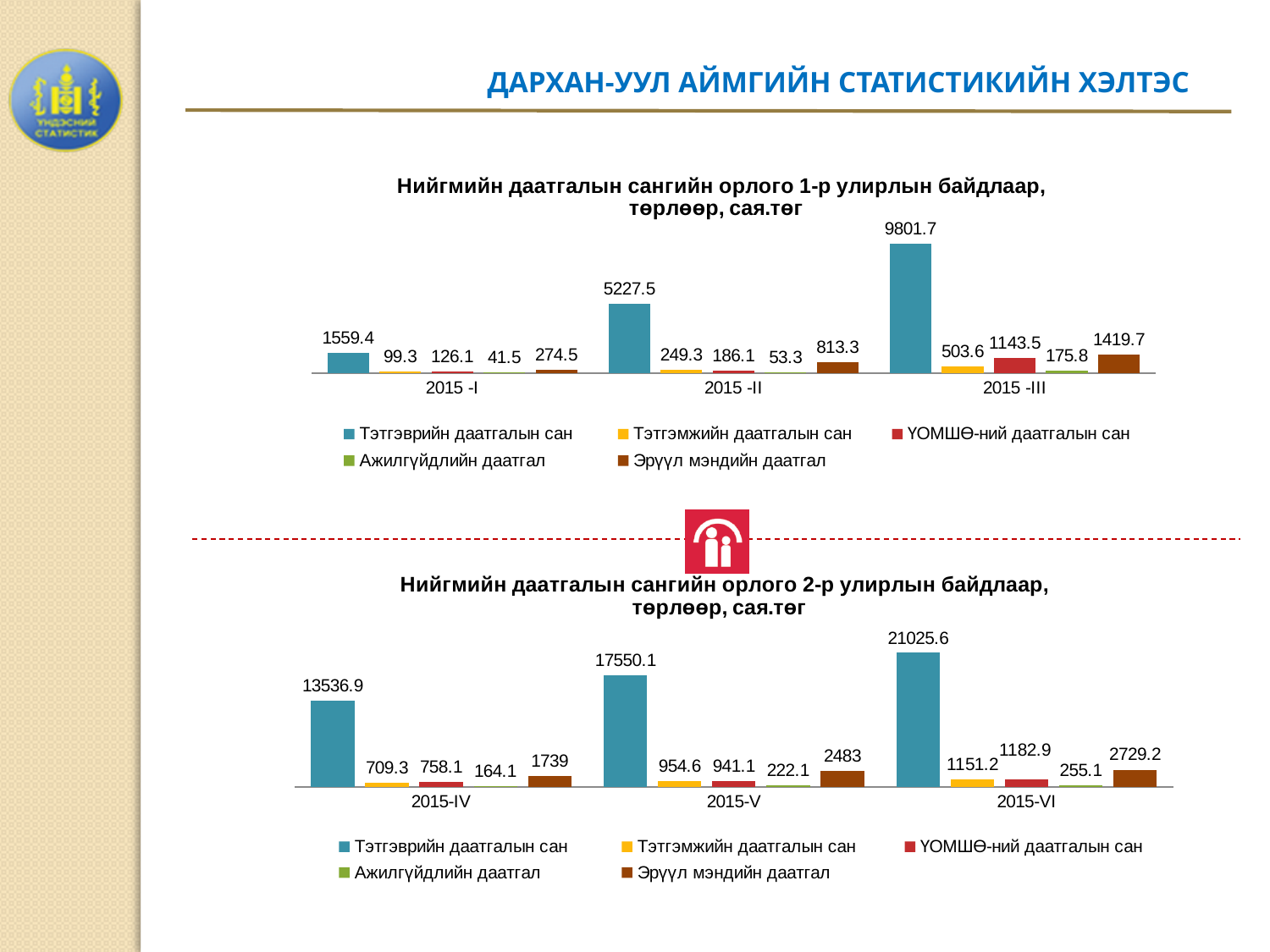
In the bottom chart (2-р улирлын байдлаар), what is the difference between the Эрүүл мэндийн даатгал values for 2015-VI and 2015-V? 246.2 In the bottom chart (2-р улирлын байдлаар), how many categories are shown on the x axis? 3 What type of chart is the bottom chart (2-р улирлын байдлаар)? bar chart In the bottom chart (2-р улирлын байдлаар), what is the value of Ажилгүйдлийн даатгал for 2015-V? 222.1 In the bottom chart (2-р улирлын байдлаар), what is the value of Тэтгэврийн даатгалын сан for 2015-VI? 21025.6 In the top chart (1-р улирлын байдлаар), what is the difference between the Тэтгэврийн даатгалын сан values for 2015 -II and 2015 -I? 3668.1 In the top chart (1-р улирлын байдлаар), what is the value of Эрүүл мэндийн даатгал for 2015 -II? 813.3 In the bottom chart (2-р улирлын байдлаар), which is larger for 2015-IV: Тэтгэмжийн даатгалын сан or ҮОМШӨ-ний даатгалын сан? ҮОМШӨ-ний даатгалын сан In the top chart (1-р улирлын байдлаар), which category has the lowest value for Ажилгүйдлийн даатгал? 2015 -I In the top chart (1-р улирлын байдлаар), does the value of Тэтгэврийн даатгалын сан rise or fall from 2015 -I to 2015 -III? rise In the top chart (1-р улирлын байдлаар), what is the value of Тэтгэврийн даатгалын сан for 2015 -III? 9801.7 In the top chart (1-р улирлын байдлаар), how many series does the legend list? 5